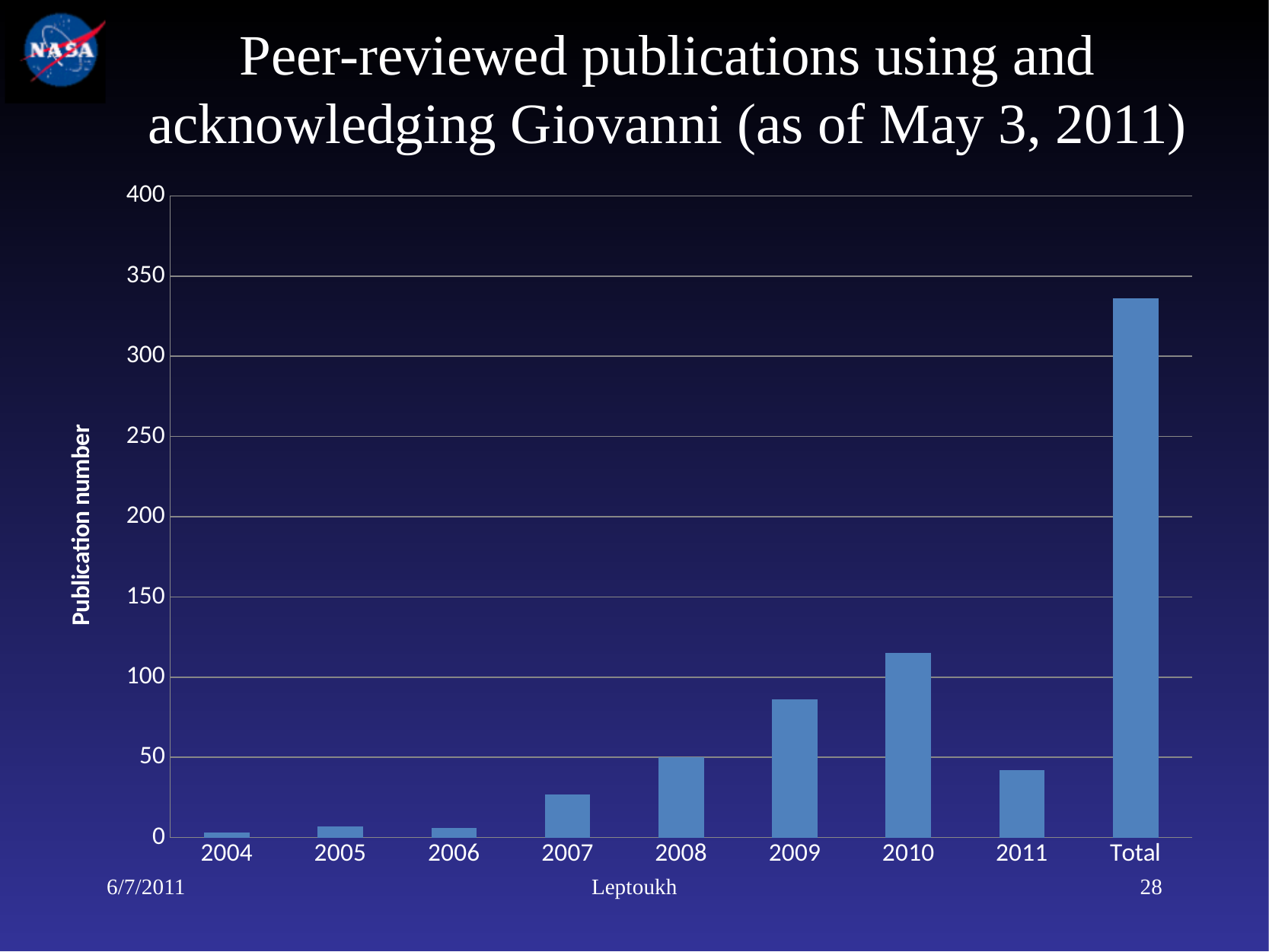
Is the value for Total greater or less than 300? greater Is the value for 2007 greater or less than 50? less Is the value for 2010 greater or less than 100? greater How many categories are shown on the x axis? 9 What kind of chart is shown on the slide? bar chart Excluding the Total bar, which year has the highest publication number? 2010 What is the label of the vertical axis? Publication number Which year has the lowest publication number? 2004 Which category has the highest bar? Total Which is larger, the value for 2009 or the value for 2011? 2009